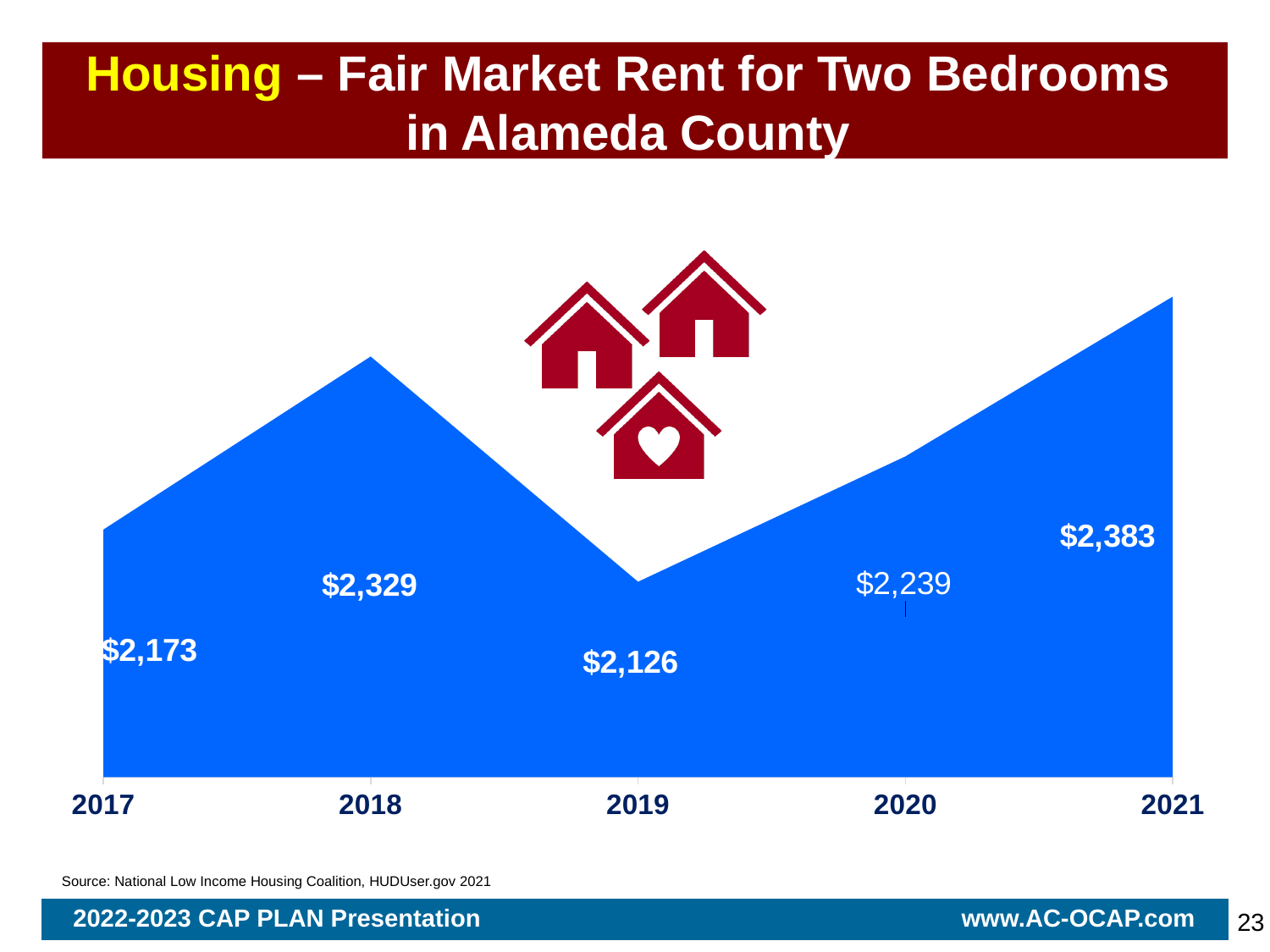
What value is shown for 2021? $2,383 What value is shown for 2020? $2,239 Which year had a higher fair market rent, 2018 or 2020? 2018 How many years are plotted on the chart? 5 What was the fair market rent for two bedrooms in Alameda County in 2017? $2,173 By how much did the fair market rent increase from 2017 to 2018? $156 Which year has the highest fair market rent shown on the chart? 2021 Which year has the lowest fair market rent shown on the chart? 2019 What is the difference between the 2021 value and the 2019 value? $257 What kind of chart is shown on the slide? Area chart Did the fair market rent rise or fall from 2019 to 2021? Rise What was the fair market rent for two bedrooms in Alameda County in 2019? $2,126